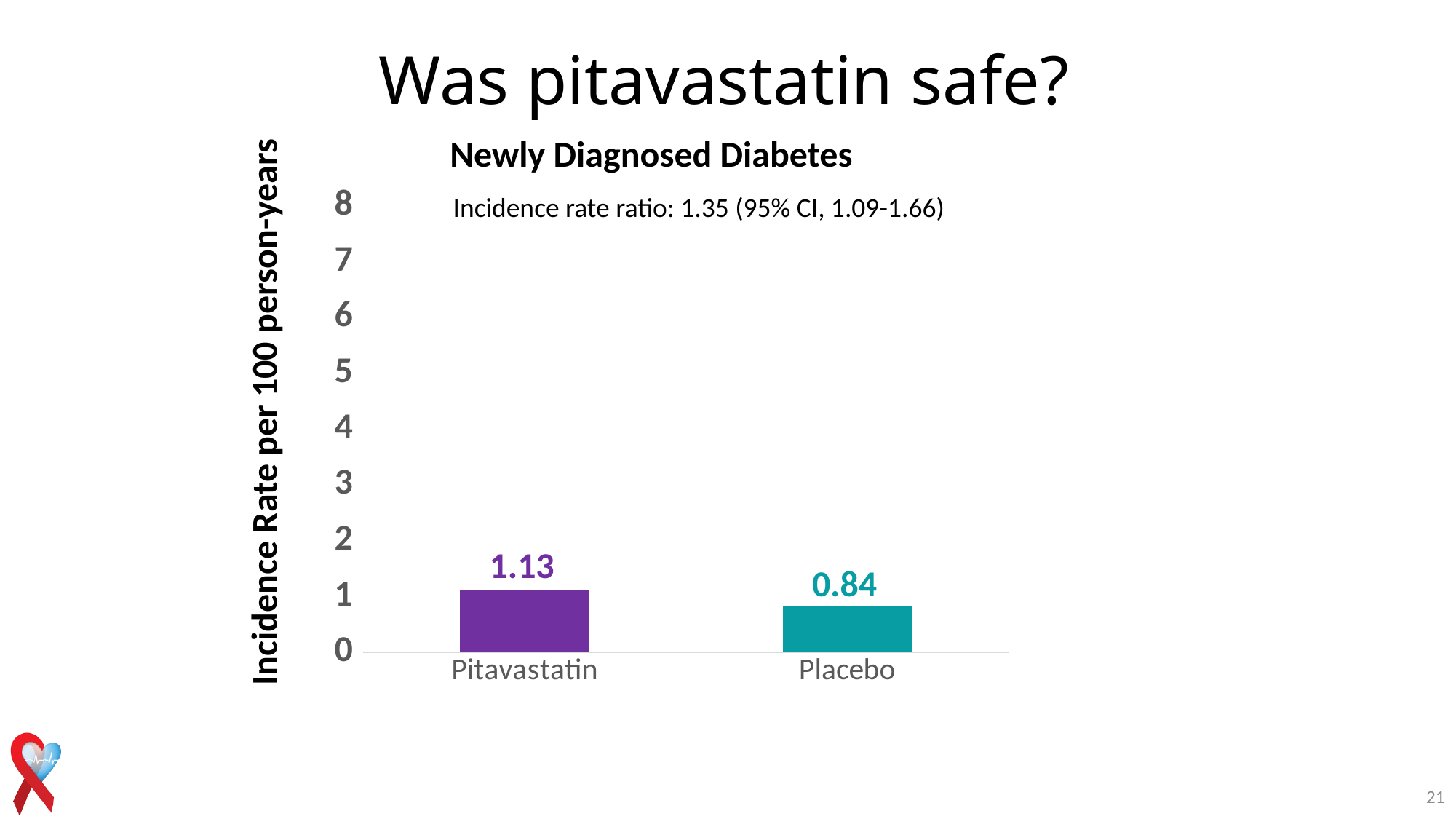
What is the incidence rate per 100 person-years for Pitavastatin? 1.13 How many categories are shown on the x axis? 2 Is the value for Placebo greater or less than 1? less What kind of chart is shown on the slide? bar chart What is the incidence rate per 100 person-years for Placebo? 0.84 Which group has the higher incidence rate of newly diagnosed diabetes? Pitavastatin Is the value for Pitavastatin greater or less than 1? greater What is the label of the y axis? Incidence Rate per 100 person-years Which group has the lower incidence rate of newly diagnosed diabetes? Placebo Is the incidence rate for Pitavastatin larger or smaller than that for Placebo? larger What is the title of the chart? Newly Diagnosed Diabetes What is the difference between the incidence rates for Pitavastatin and Placebo? 0.29